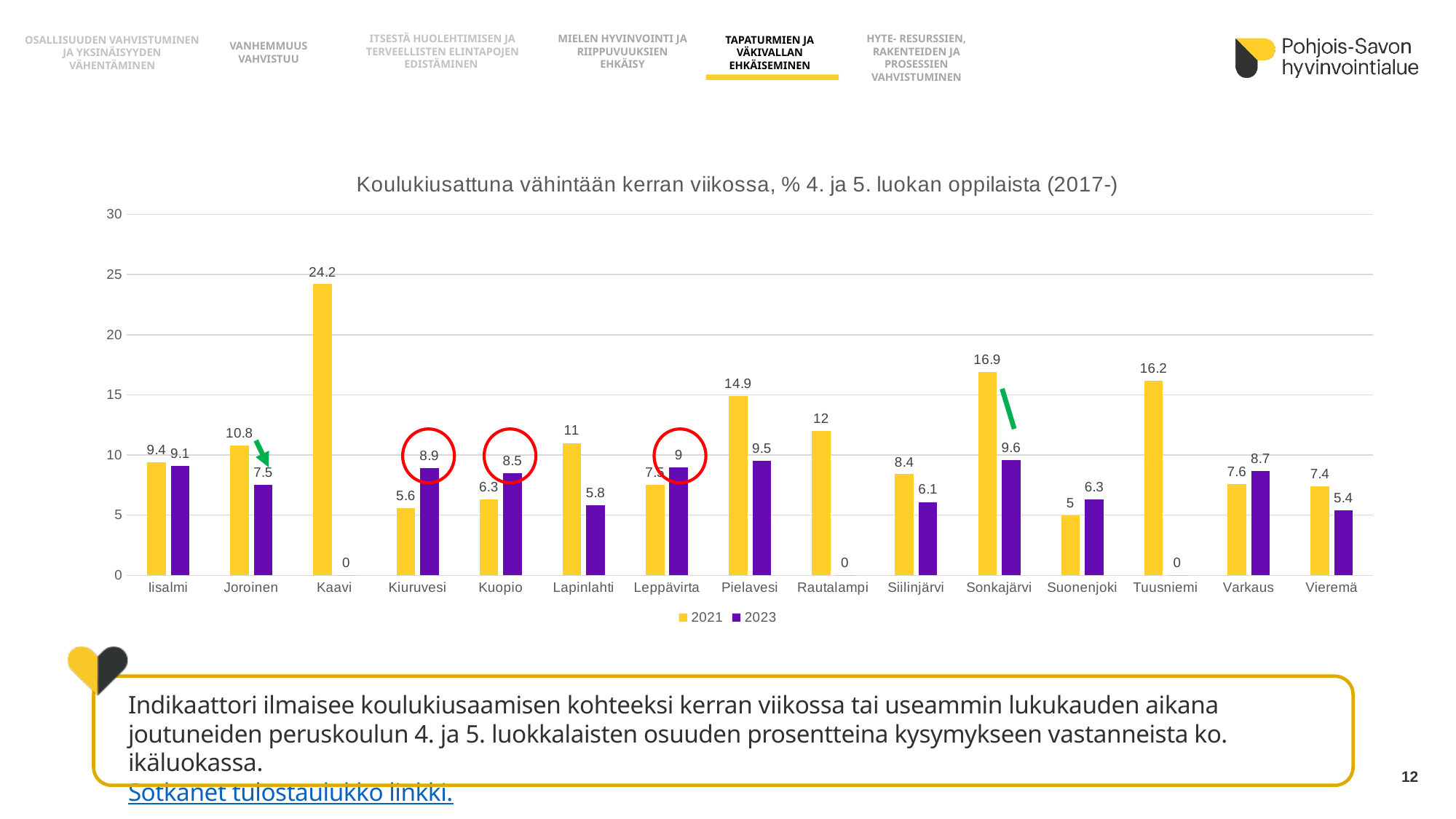
What is the 2023 value for Sonkajärvi? 9.6 What is the difference between the 2021 and 2023 values for Joroinen? 3.3 Is the 2021 value for Tuusniemi greater or less than 15? greater How many series does the legend list? 2 Which municipality has the lowest 2021 value? Suonenjoki What is the difference between the 2021 and 2023 values for Pielavesi? 5.4 Which municipality has the highest 2021 value? Kaavi For Kiuruvesi, which year has the larger value, 2021 or 2023? 2023 What is the 2023 value for Lapinlahti? 5.8 What is the 2021 value for Kaavi? 24.2 What kind of chart is shown on the slide? bar chart How many municipalities are shown on the x axis? 15